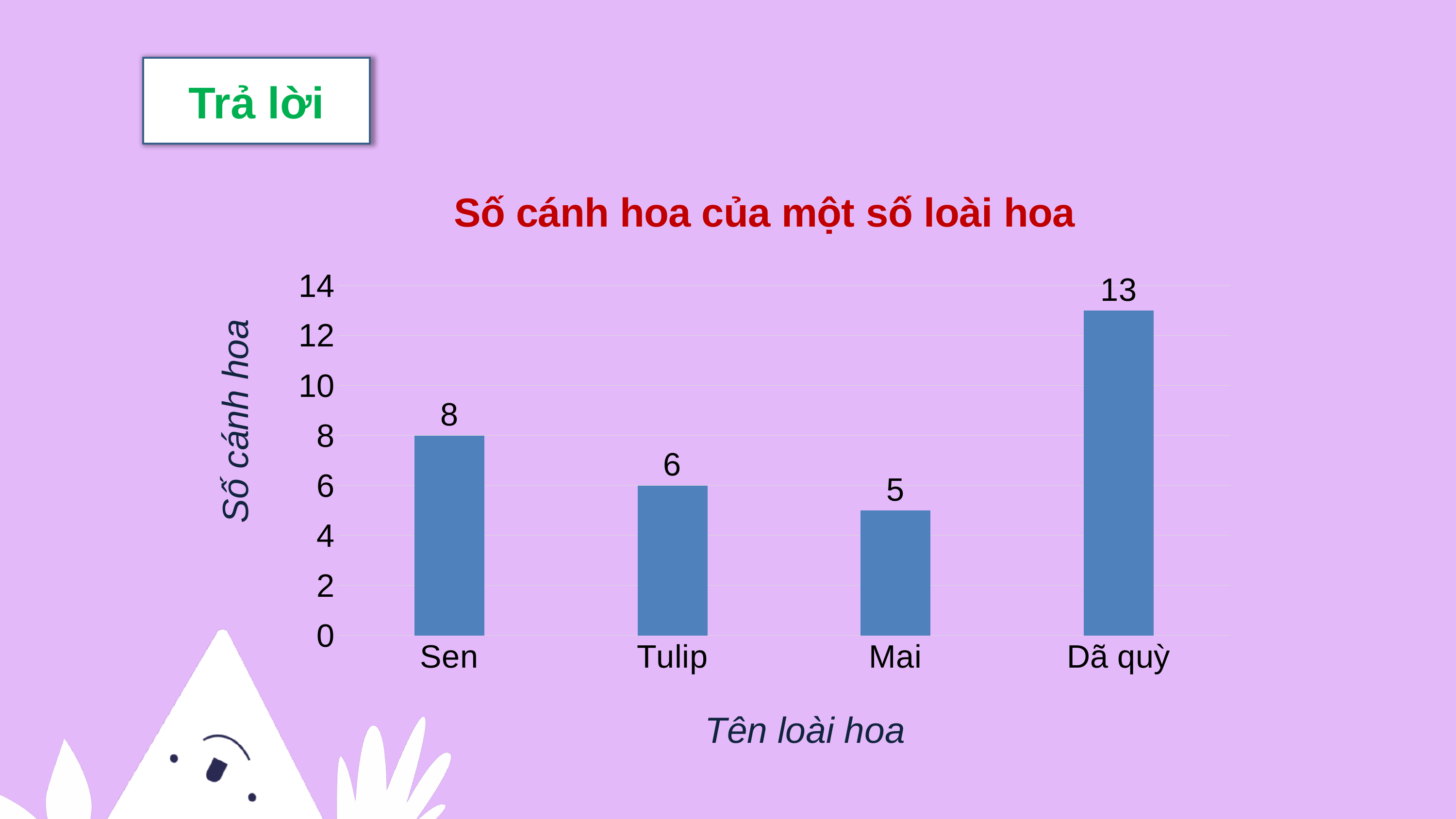
Which has more petals, Sen or Tulip? Sen Is the value for Dã quỳ greater or less than 10? greater What is the number of petals shown for Mai? 5 What is the difference between the number of petals for Dã quỳ and Sen? 5 What is the difference between the number of petals for Tulip and Mai? 1 What kind of chart is shown on the slide? bar chart How many flower types are shown in the chart? 4 What is the number of petals shown for Tulip? 6 Which flower has the highest number of petals? Dã quỳ Which flower has the lowest number of petals? Mai What is the number of petals shown for Dã quỳ? 13 What is the number of petals shown for Sen? 8